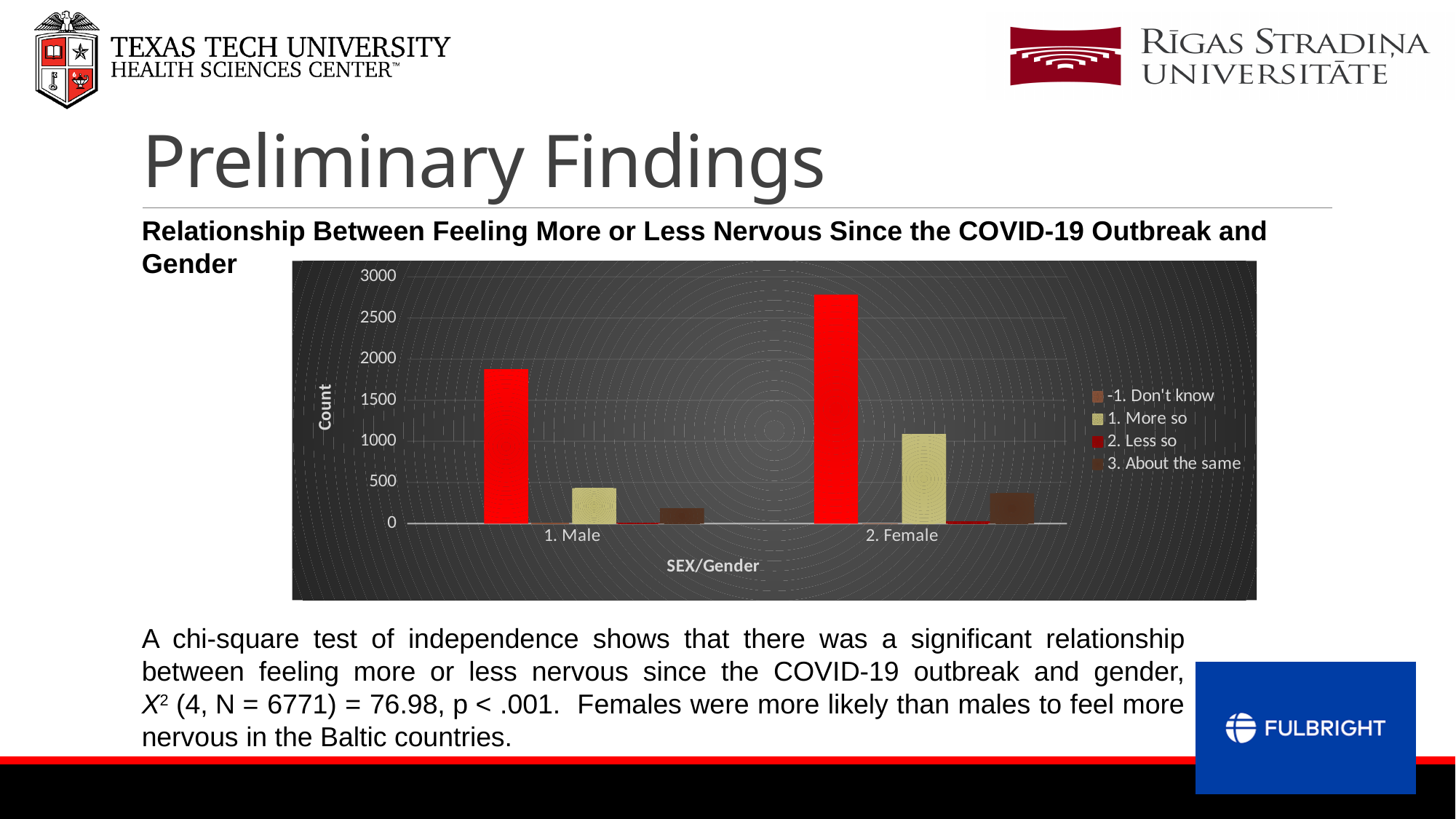
What kind of chart is shown on the slide? bar chart How many gender categories are shown on the x axis of the chart? 2 Is the tallest bar for 2. Female greater or less than 2500? greater Which category has the larger '1. More so' value, 1. Male or 2. Female? 2. Female Is the tallest bar for 1. Male greater or less than 1500? greater Which category has the taller tallest bar, 1. Male or 2. Female? 2. Female Is the value of '1. More so' for 1. Male greater or less than 500? less How many series does the chart's legend list? 4 What is the label of the chart's vertical axis? Count What is the title of the chart? Relationship Between Feeling More or Less Nervous Since the COVID-19 Outbreak and Gender